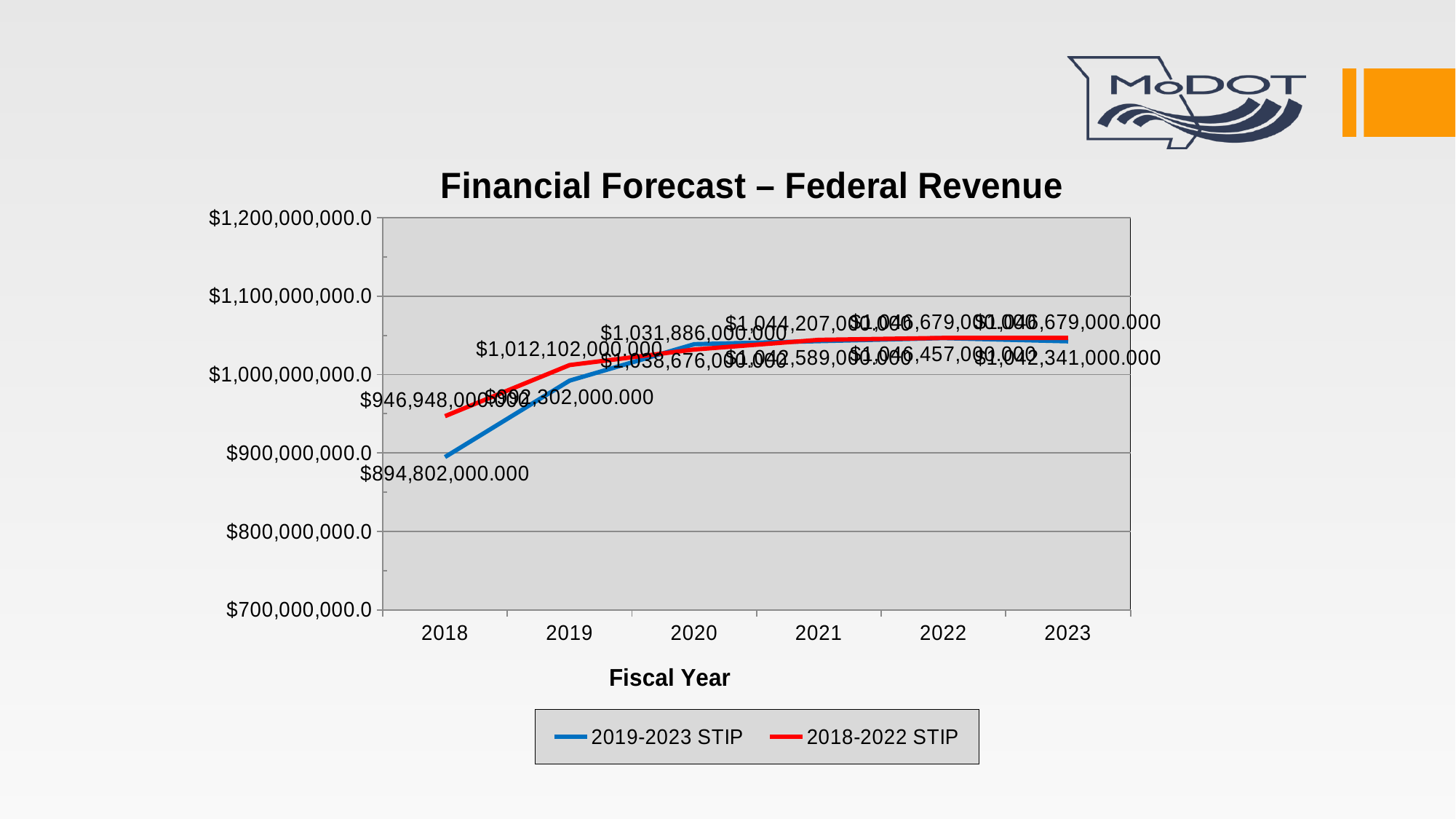
How many fiscal years are plotted on the x axis? 6 Is the 2019-2023 STIP value for fiscal year 2021 greater or less than $1,000,000,000.0? greater What is the title of the x axis? Fiscal Year What is the 2018-2022 STIP value for fiscal year 2019? $1,012,102,000.000 In which fiscal year is the 2019-2023 STIP value lowest? 2018 Is the 2019-2023 STIP value for fiscal year 2018 greater or less than $900,000,000.0? less In fiscal year 2018, which series has the higher value, 2019-2023 STIP or 2018-2022 STIP? 2018-2022 STIP What is the difference between the 2018-2022 STIP and 2019-2023 STIP values in fiscal year 2018? $52,146,000.000 What kind of chart is shown on the slide? line chart What is the 2019-2023 STIP value for fiscal year 2018? $894,802,000.000 How many series does the legend list? 2 What is the 2018-2022 STIP value for fiscal year 2018? $946,948,000.000